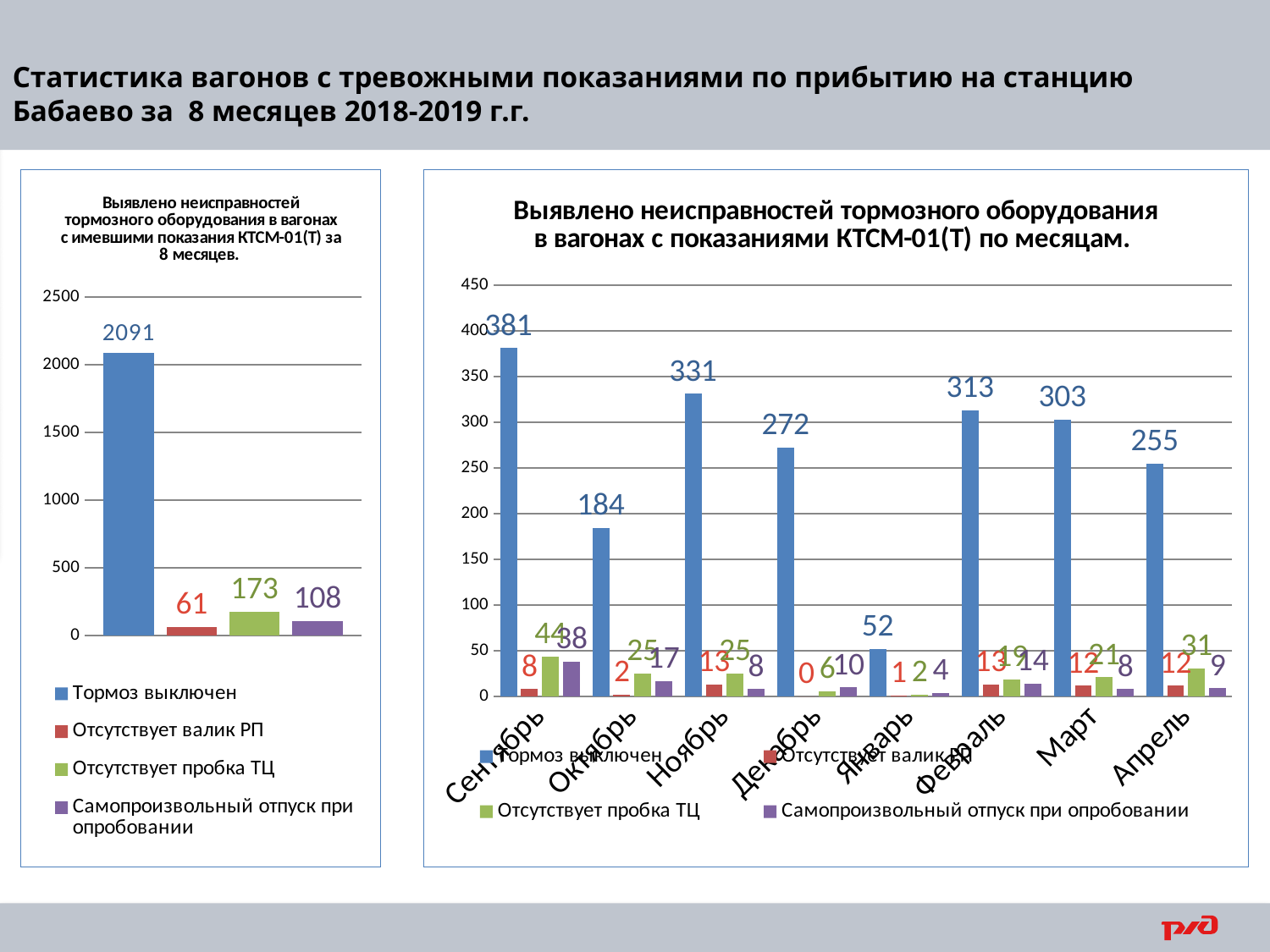
In the right chart, what is the difference in 'Тормоз выключен' between Февраль and Март? 10 What type of chart is the right chart? Bar chart In the right chart, in which month is 'Тормоз выключен' highest? Сентябрь In the left chart, how many categories are shown? 4 In the right chart, what is the value of 'Тормоз выключен' for Ноябрь? 331 In the right chart, in which month is 'Тормоз выключен' lowest? Январь In the right chart, how many series does the legend list? 4 In the left chart, what is the difference between 'Отсутствует пробка ТЦ' and 'Самопроизвольный отпуск при опробовании'? 65 In the right chart, is 'Тормоз выключен' for Апрель greater or less than 250? greater In the left chart, what is the value for 'Тормоз выключен'? 2091 In the left chart, which category has the lowest value? Отсутствует валик РП In the left chart, what is the value for 'Отсутствует пробка ТЦ'? 173